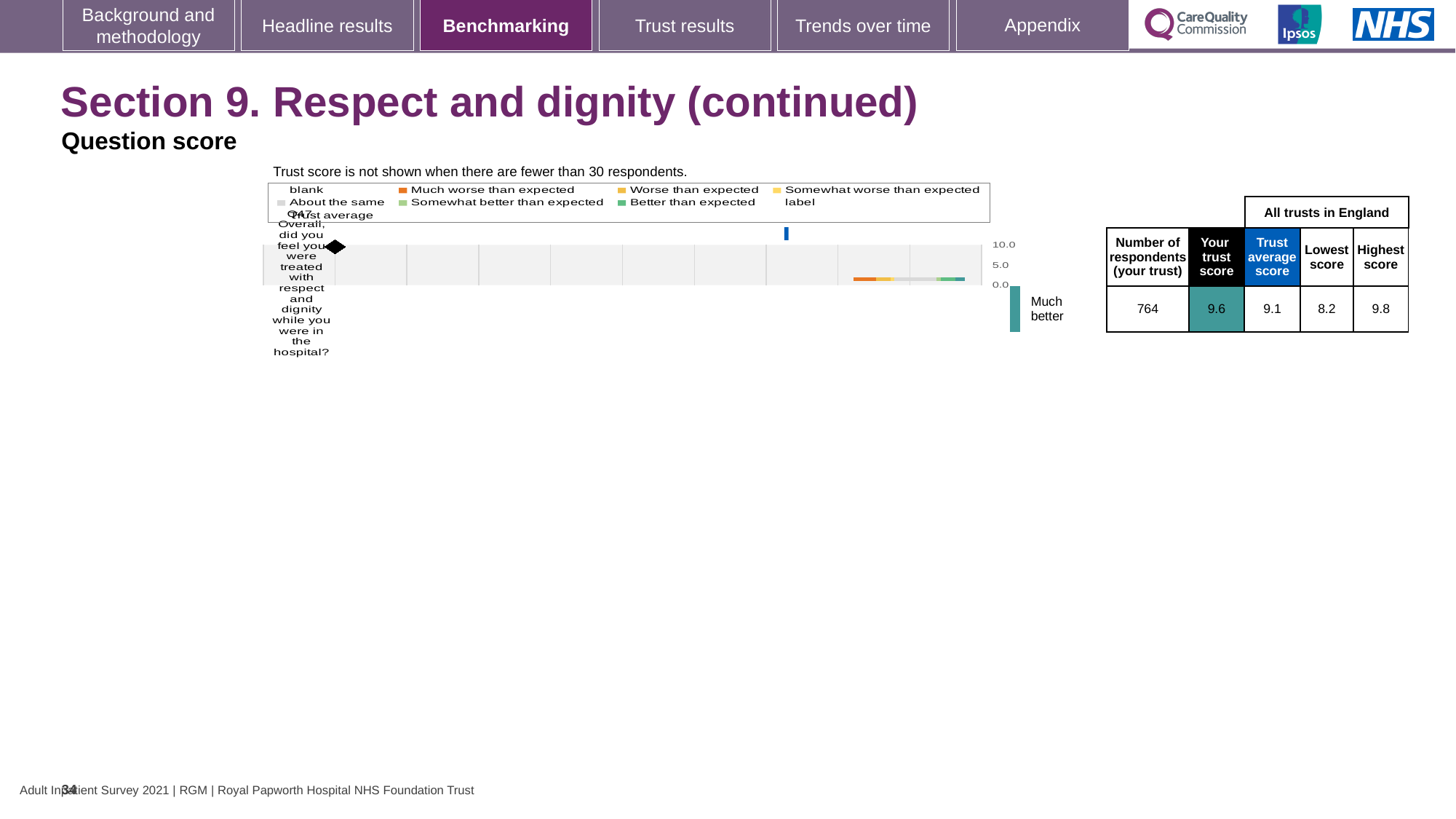
According to the table next to the chart, what is the lowest score among all trusts in England? 8.2 According to the table next to the chart, how many respondents did the trust have for this question? 764 According to the table next to the chart, what is the highest score among all trusts in England? 9.8 What is the highest value shown on the chart's numeric axis? 10.0 How many question categories are plotted on the chart? 1 What kind of chart is shown on the slide? bar chart Is the trust score (9.6) higher or lower than the trust average score (9.1)? higher According to the table next to the chart, what is the trust average score for all trusts in England? 9.1 According to the table next to the chart, what is the trust score for the question about being treated with respect and dignity? 9.6 Which legend entry is shown with an orange marker? Much worse than expected What is the difference between the highest score (9.8) and the lowest score (8.2) in the table? 1.6